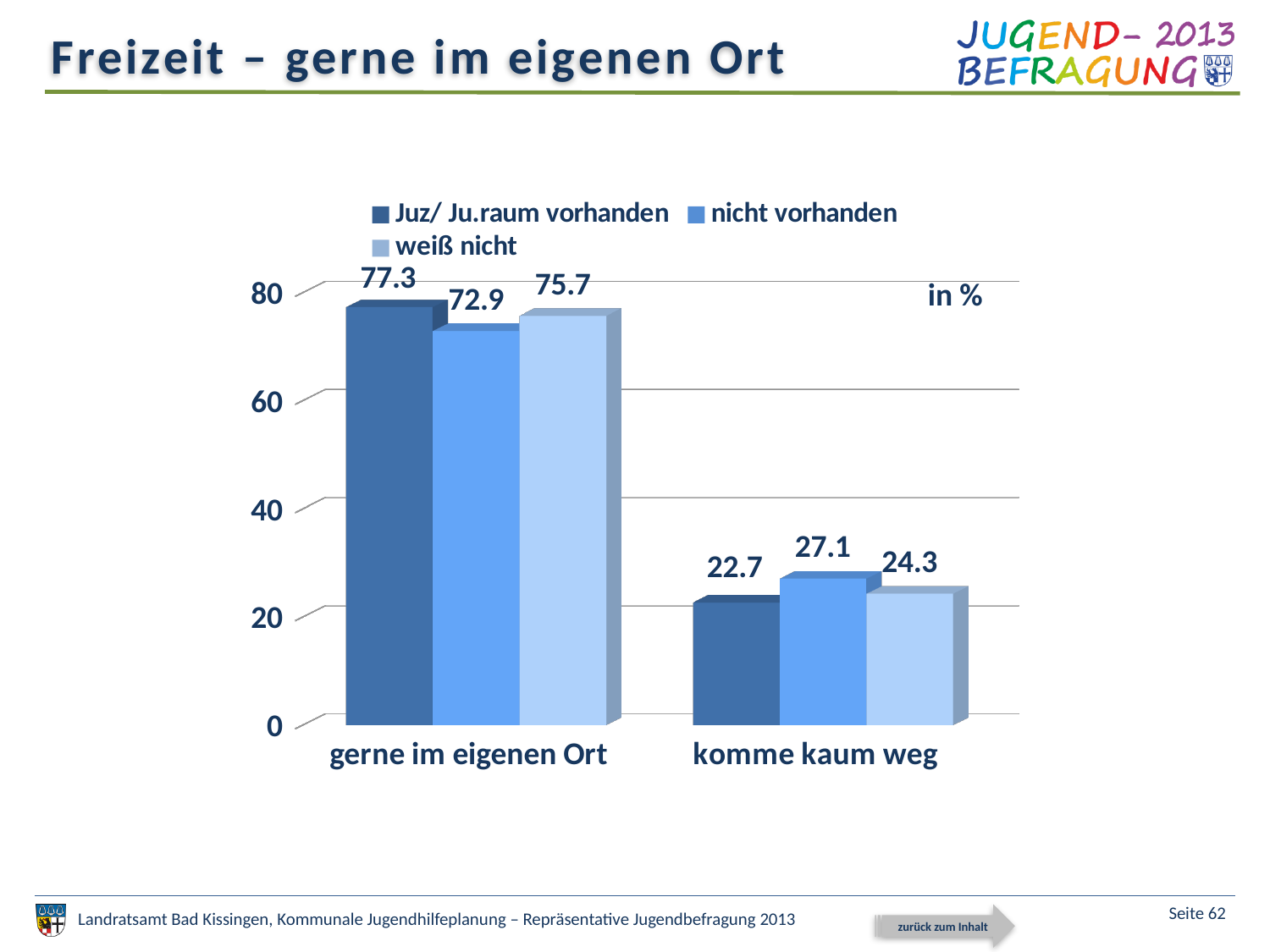
What is the difference between the 'Juz/ Ju.raum vorhanden' values for 'gerne im eigenen Ort' and 'komme kaum weg'? 54.6 What is the value for 'weiß nicht' in the 'gerne im eigenen Ort' category? 75.7 Which series has the highest value in the 'komme kaum weg' category? nicht vorhanden What unit is indicated in the chart's upper right corner? in % What kind of chart is shown on the slide? bar chart What is the value for 'Juz/ Ju.raum vorhanden' in the 'gerne im eigenen Ort' category? 77.3 What is the value for 'nicht vorhanden' in the 'komme kaum weg' category? 27.1 How many categories are shown on the x axis? 2 Which series has the lowest value in the 'gerne im eigenen Ort' category? nicht vorhanden What is the value for 'Juz/ Ju.raum vorhanden' in the 'komme kaum weg' category? 22.7 Which is larger: the 'weiß nicht' value for 'gerne im eigenen Ort' or the 'nicht vorhanden' value for 'gerne im eigenen Ort'? weiß nicht (75.7) How many series does the legend list? 3